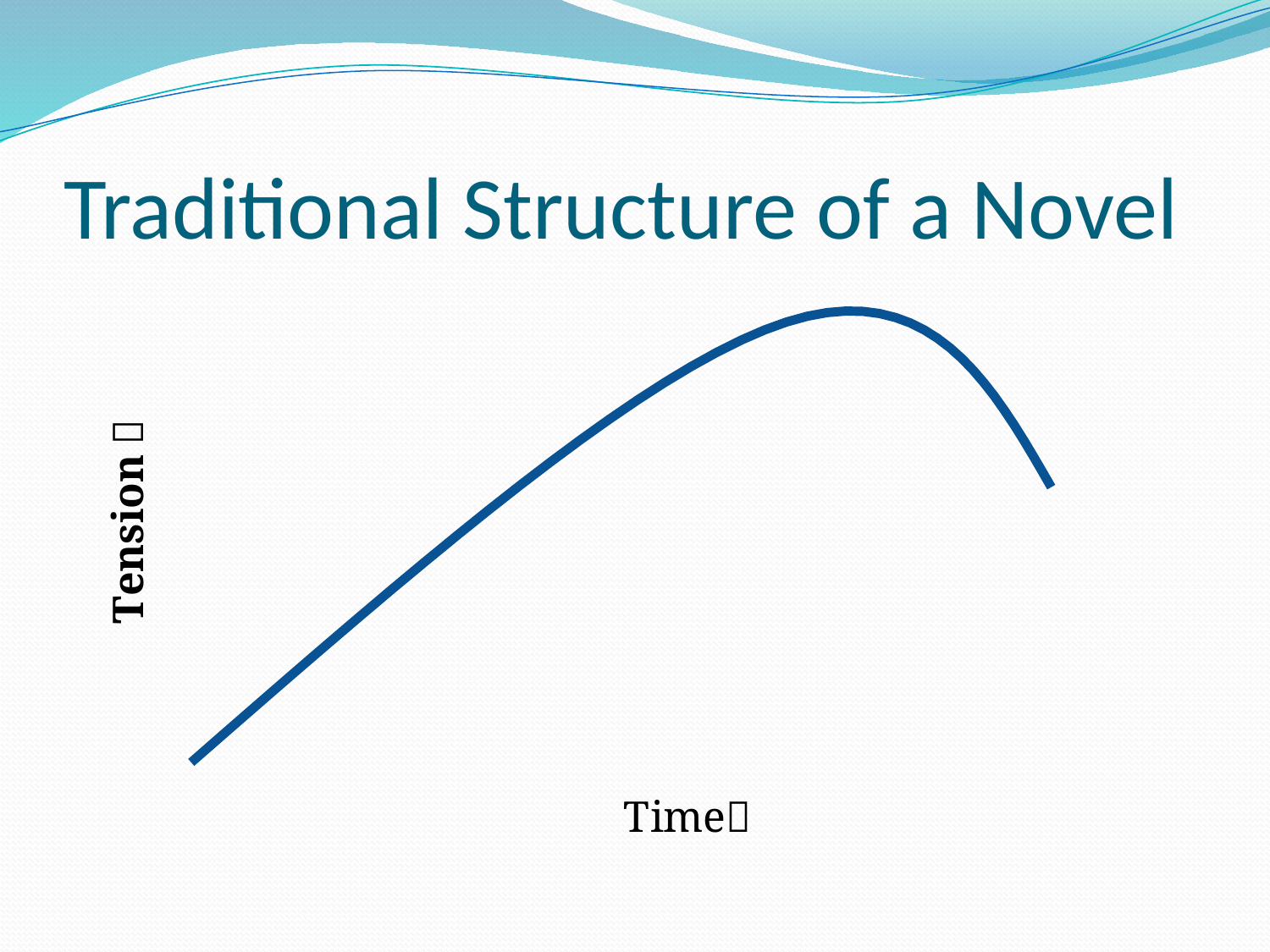
What label is on the vertical axis of the chart? Tension What label is on the horizontal axis of the chart? Time Is the tension at the right end of the line higher or lower than at the left end? higher How does the line behave along the x axis from left to right? rises, then falls How many lines are plotted on the chart? 1 Does the line rise or fall at the right end of the x axis? falls What kind of chart is shown on the slide? line chart Does the line rise or fall over the first part of the x axis? rises Is the peak of the line closer to the left end or the right end of the x axis? right end